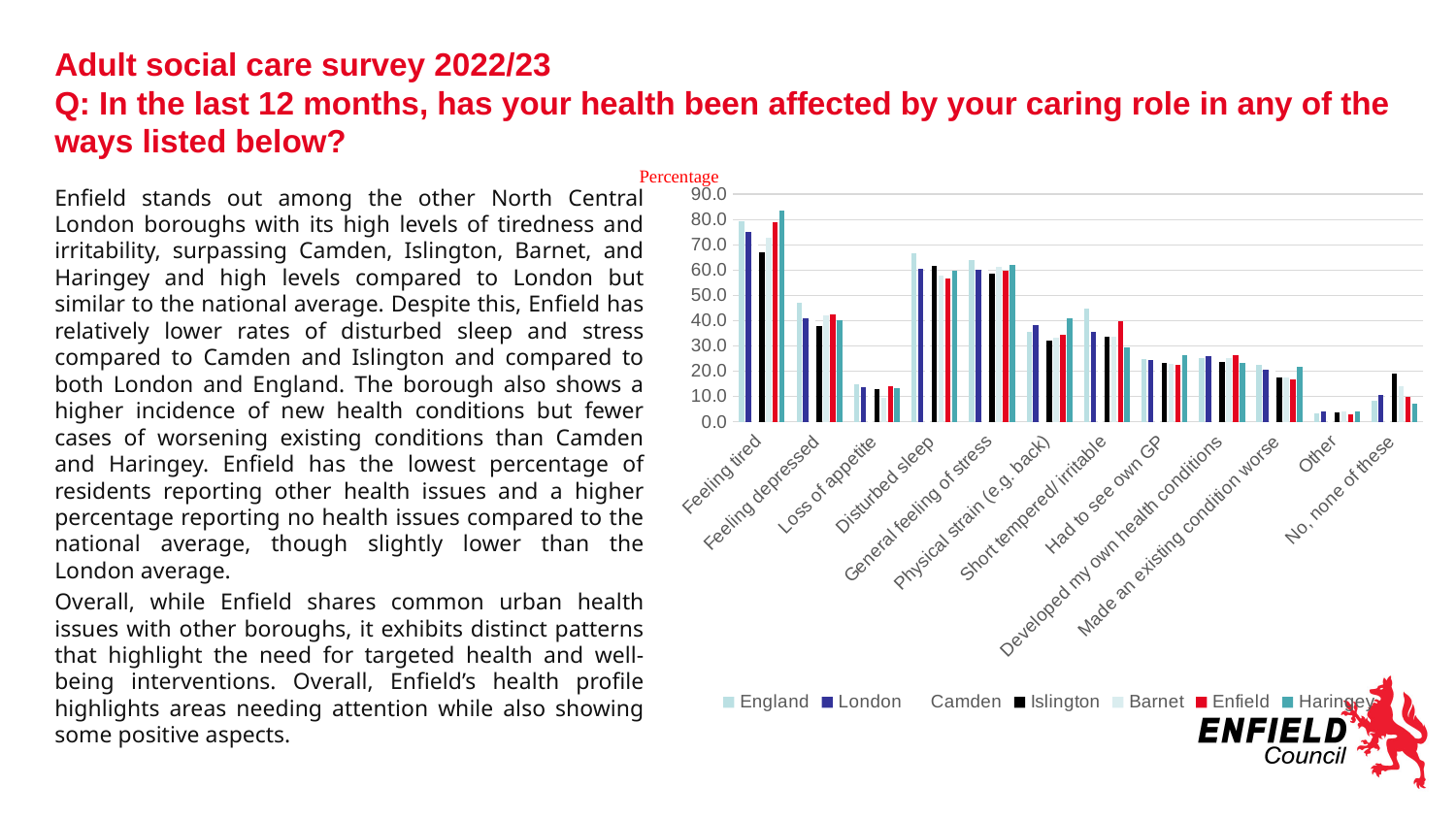
Is the value for Haringey in 'Feeling tired' greater or less than 80? greater How many series does the legend list? 7 Is the value for England in 'Disturbed sleep' greater or less than 60? greater Within the 'Feeling tired' category, which borough has the highest bar? Haringey How many categories are shown along the x axis? 12 What kind of chart is shown on the slide? bar chart Which category has the highest bars overall? Feeling tired What is the label on the vertical axis? Percentage Is the value for Islington in 'Feeling tired' greater or less than 70? less Which is larger for 'Disturbed sleep': England or Enfield? England Which category has the lowest bars overall? Other Which is larger for 'Short tempered/ irritable': Enfield or Haringey? Enfield